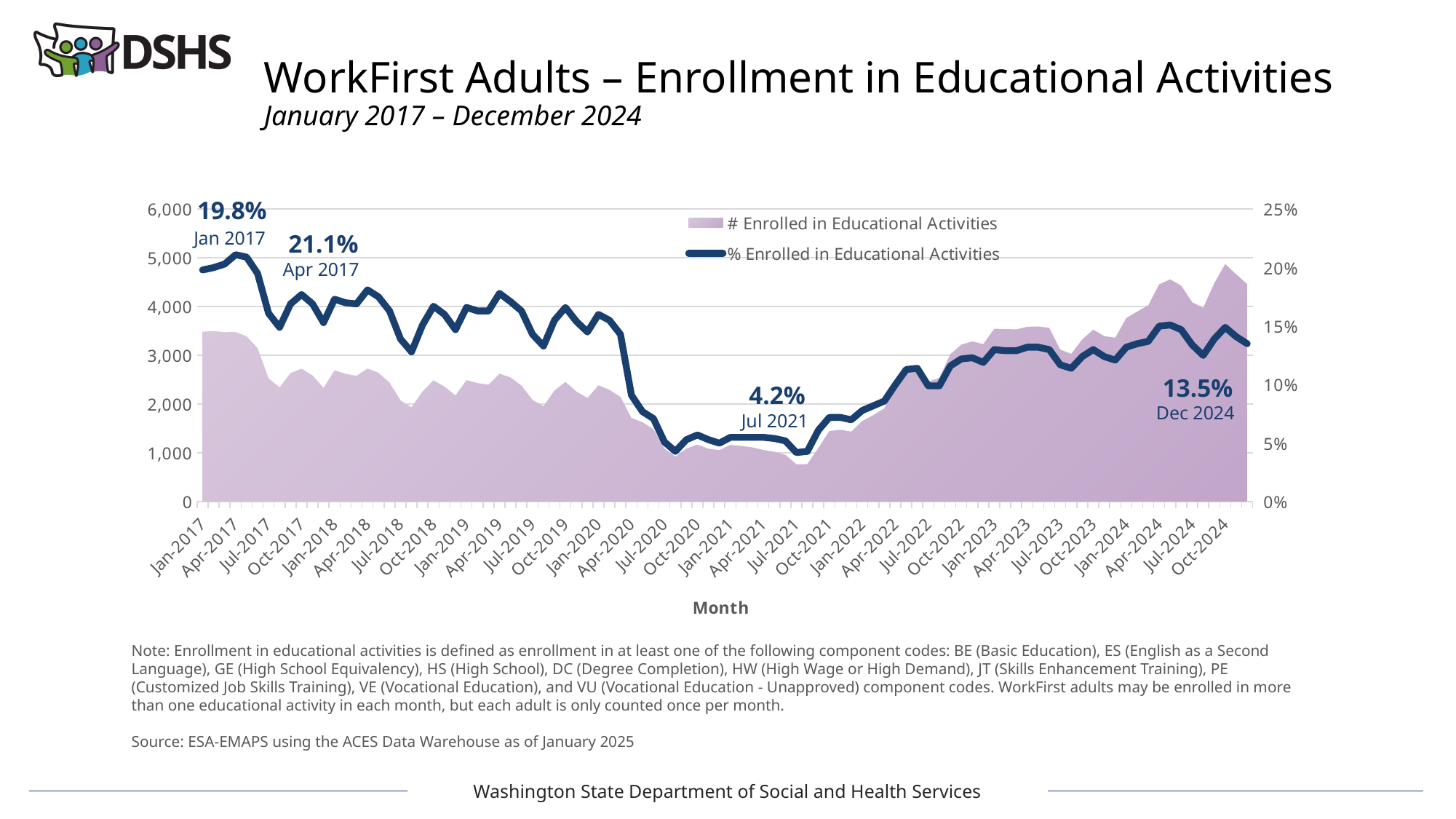
What was the % Enrolled in Educational Activities in Dec 2024? 13.5% Is the # Enrolled in Educational Activities in Oct 2024 greater or less than 4,000? greater Which labeled month has the lowest % Enrolled in Educational Activities? Jul 2021 What was the % Enrolled in Educational Activities in Jan 2017? 19.8% What was the % Enrolled in Educational Activities in Apr 2017? 21.1% Which labeled month has the highest % Enrolled in Educational Activities? Apr 2017 Is the # Enrolled in Educational Activities in Jul 2020 greater or less than 2,000? less What was the % Enrolled in Educational Activities in Jul 2021? 4.2% How many series does the legend list? 2 What is the difference in percentage points between the % enrolled in Apr 2017 and Jul 2021? 16.9 percentage points Which is larger, the % enrolled in Jan 2017 or in Dec 2024? Jan 2017 Does the % Enrolled in Educational Activities generally rise or fall from Jul 2021 to Dec 2024? rise